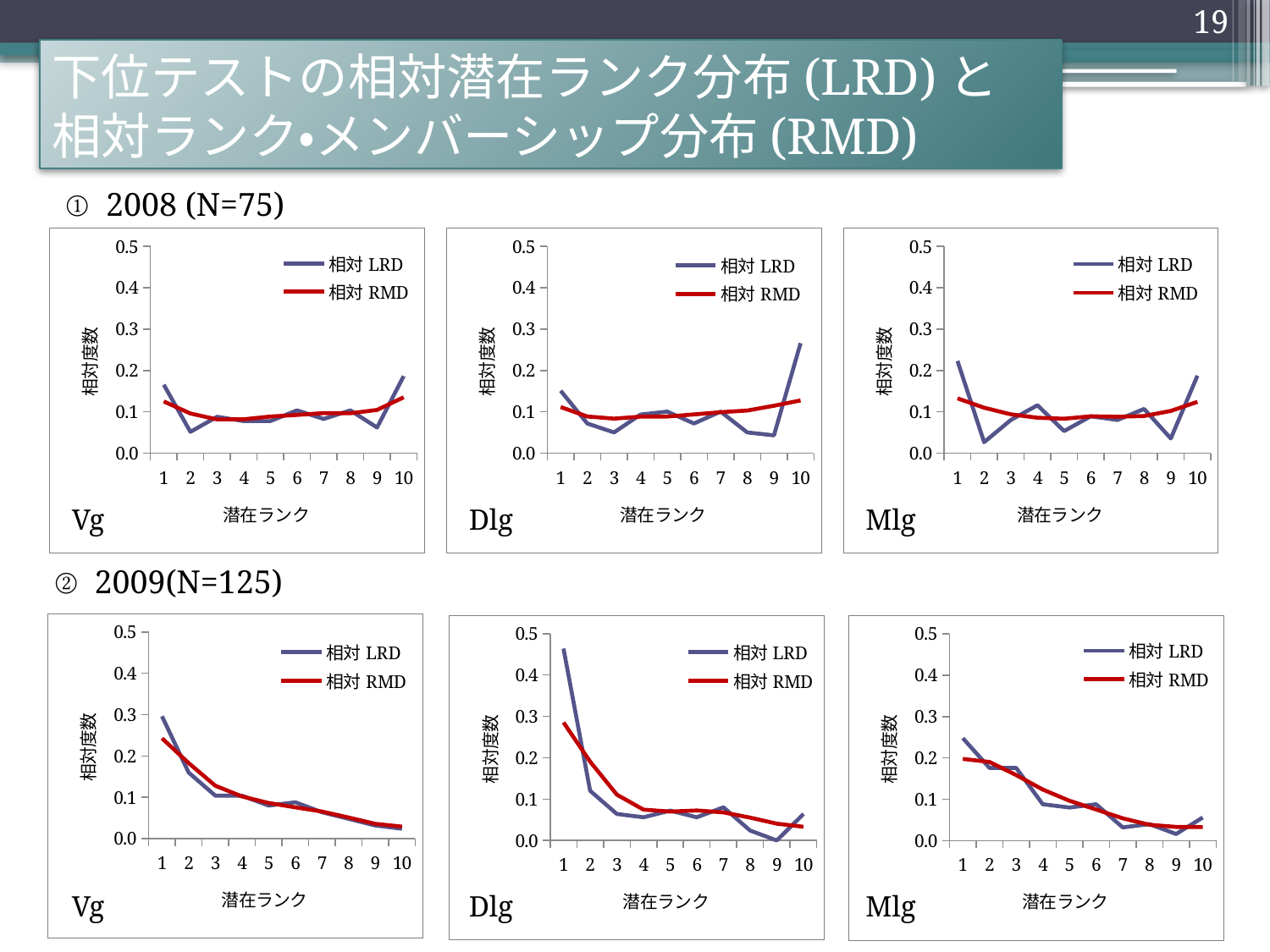
In the 2008 Dlg chart (top middle), is the 相対 LRD value at 潜在ランク 10 greater or less than 0.2? greater What kind of chart is the 2008 Vg chart (top left)? line chart In the 2008 Dlg chart (top middle), at which 潜在ランク is the 相対 LRD value highest? 10 What are the two legend entries in the 2008 Vg chart (top left)? 相対 LRD, 相対 RMD In the 2009 Vg chart (bottom left), does the 相対 RMD line generally rise or fall as 潜在ランク increases from 1 to 10? fall In the 2009 Dlg chart (bottom middle), is the 相対 LRD value at 潜在ランク 1 greater or less than 0.4? greater In the 2009 Dlg chart (bottom middle), at which 潜在ランク is the 相対 LRD value highest? 1 What is the y-axis label of the 2009 Mlg chart (bottom right)? 相対度数 In the 2008 Mlg chart (top right), is the 相対 LRD value at 潜在ランク 2 greater or less than 0.1? less How many series does the legend of the 2009 Dlg chart (bottom middle) list? 2 In the 2009 Dlg chart (bottom middle), at 潜在ランク 1, which series has the larger value, 相対 LRD or 相対 RMD? 相対 LRD How many 潜在ランク categories are shown on the x axis of the 2008 Mlg chart (top right)? 10